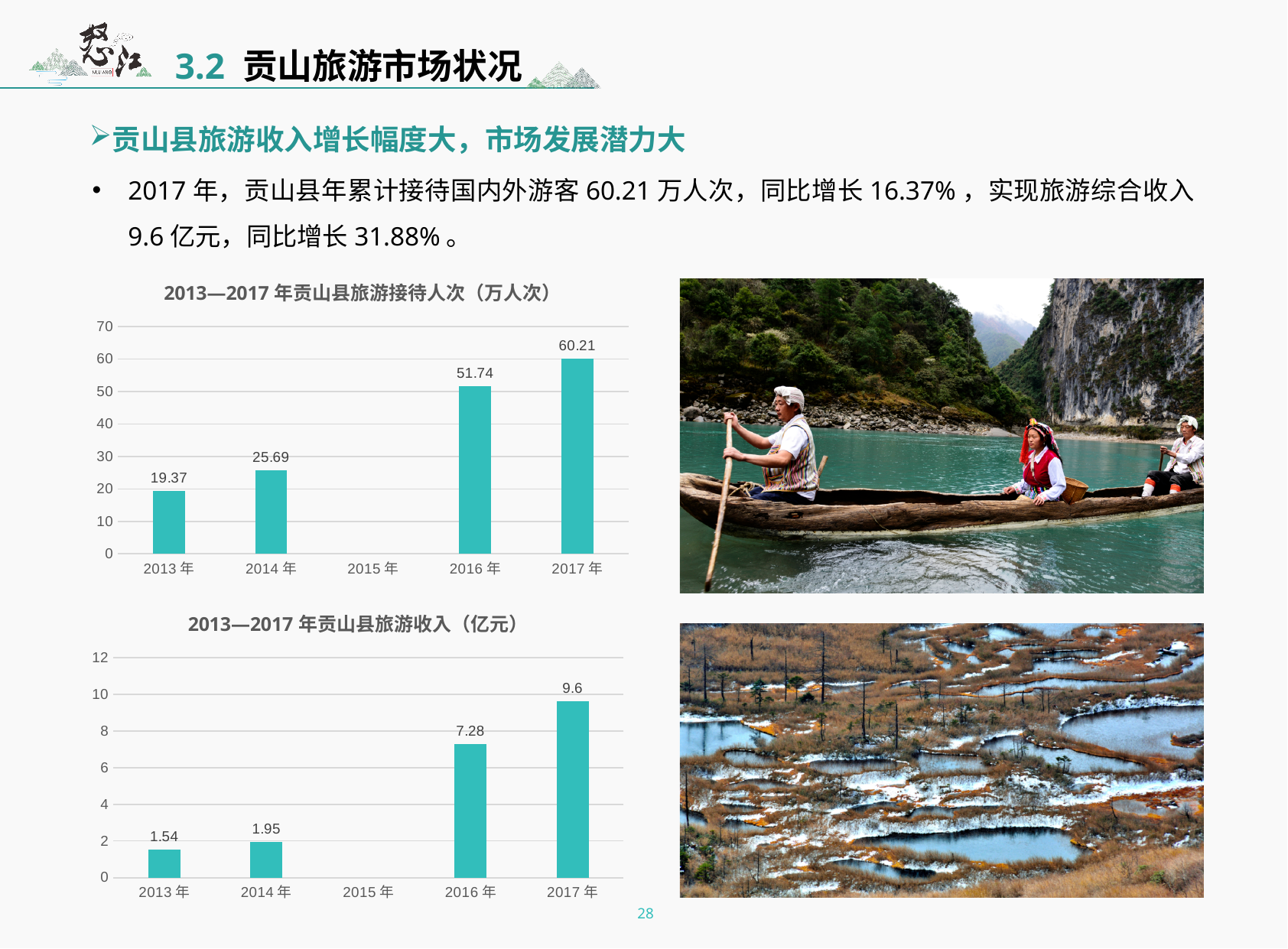
In the top chart (2013—2017年贡山县旅游接待人次), what is the difference between the 2017年 and 2016年 values? 8.47 In the top chart (2013—2017年贡山县旅游接待人次), how many year labels are shown on the x axis? 5 In the top chart (2013—2017年贡山县旅游接待人次), what is the value for 2014年? 25.69 In the bottom chart (2013—2017年贡山县旅游收入), which year has the highest value? 2017年 In the bottom chart (2013—2017年贡山县旅游收入), what is the value for 2013年? 1.54 In the top chart (2013—2017年贡山县旅游接待人次), what is the value for 2017年? 60.21 In the bottom chart (2013—2017年贡山县旅游收入), what is the value for 2016年? 7.28 What type of chart is the bottom chart (2013—2017年贡山县旅游收入)? bar chart In the top chart (2013—2017年贡山县旅游接待人次), which year has the lowest value? 2013年 In the bottom chart (2013—2017年贡山县旅游收入), which is larger, the value for 2016年 or 2017年? 2017年 In the bottom chart (2013—2017年贡山县旅游收入), what is the difference between the 2014年 and 2013年 values? 0.41 In the top chart (2013—2017年贡山县旅游接待人次), do the plotted values rise or fall from 2013年 to 2017年? rise